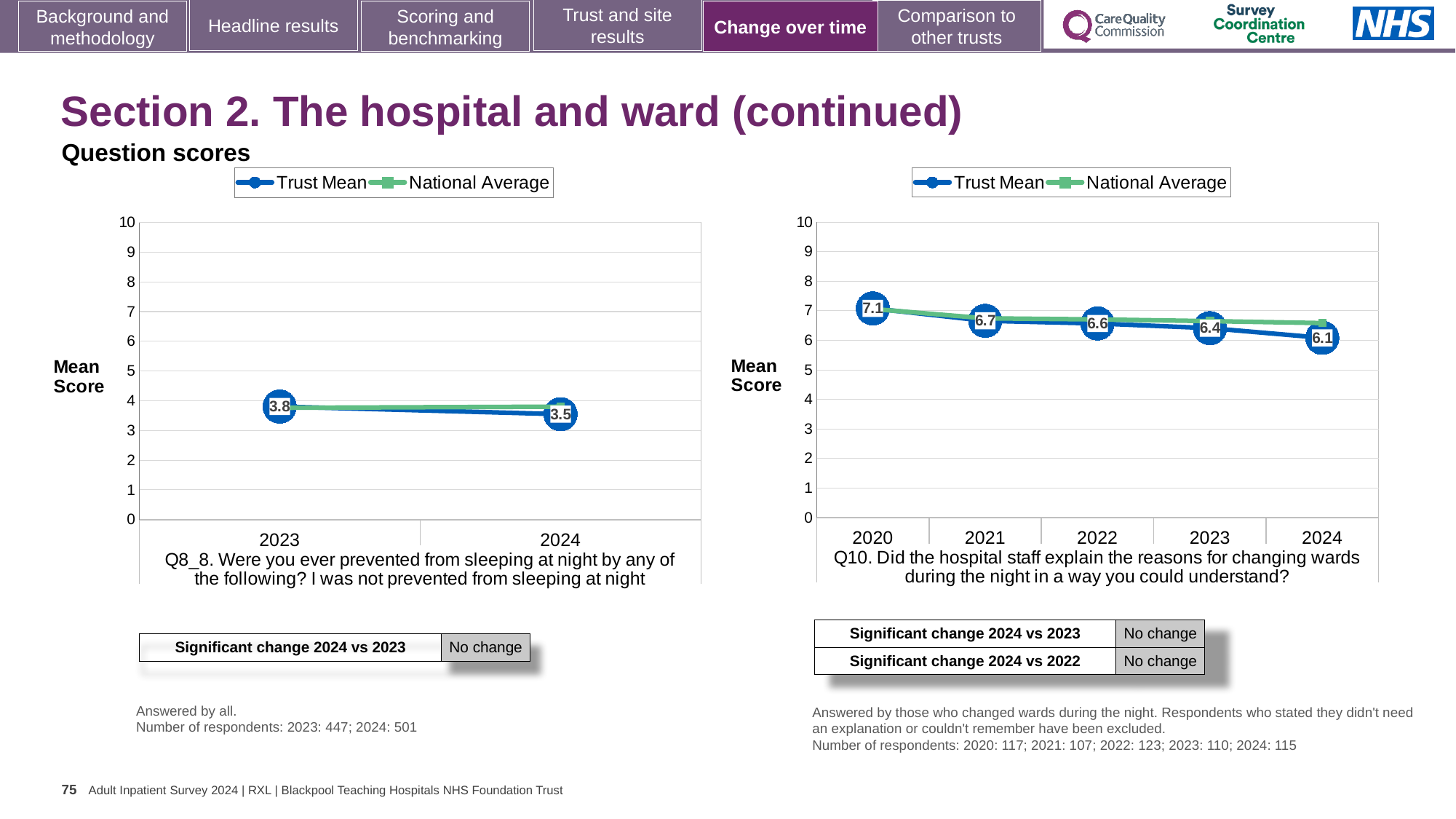
How many series does the legend of the right chart (Q10) list? 2 In the left chart (Q8_8), how many years are plotted on the x axis? 2 In the left chart (Q8_8), what is the Trust Mean for 2023? 3.8 In the left chart (Q8_8), what is the Trust Mean for 2024? 3.5 In the right chart (Q10), what is the difference between the Trust Mean for 2020 and 2024? 1.0 In the right chart (Q10), does the Trust Mean rise or fall from 2020 to 2024? fall In the right chart (Q10), which year has the highest Trust Mean? 2020 In the right chart (Q10), what is the Trust Mean for 2020? 7.1 In the right chart (Q10), which year has the lowest Trust Mean? 2024 What type of chart is the left chart (Q8_8)? line chart In the left chart (Q8_8), what is the difference between the Trust Mean for 2023 and 2024? 0.3 In the right chart (Q10), what is the Trust Mean for 2024? 6.1